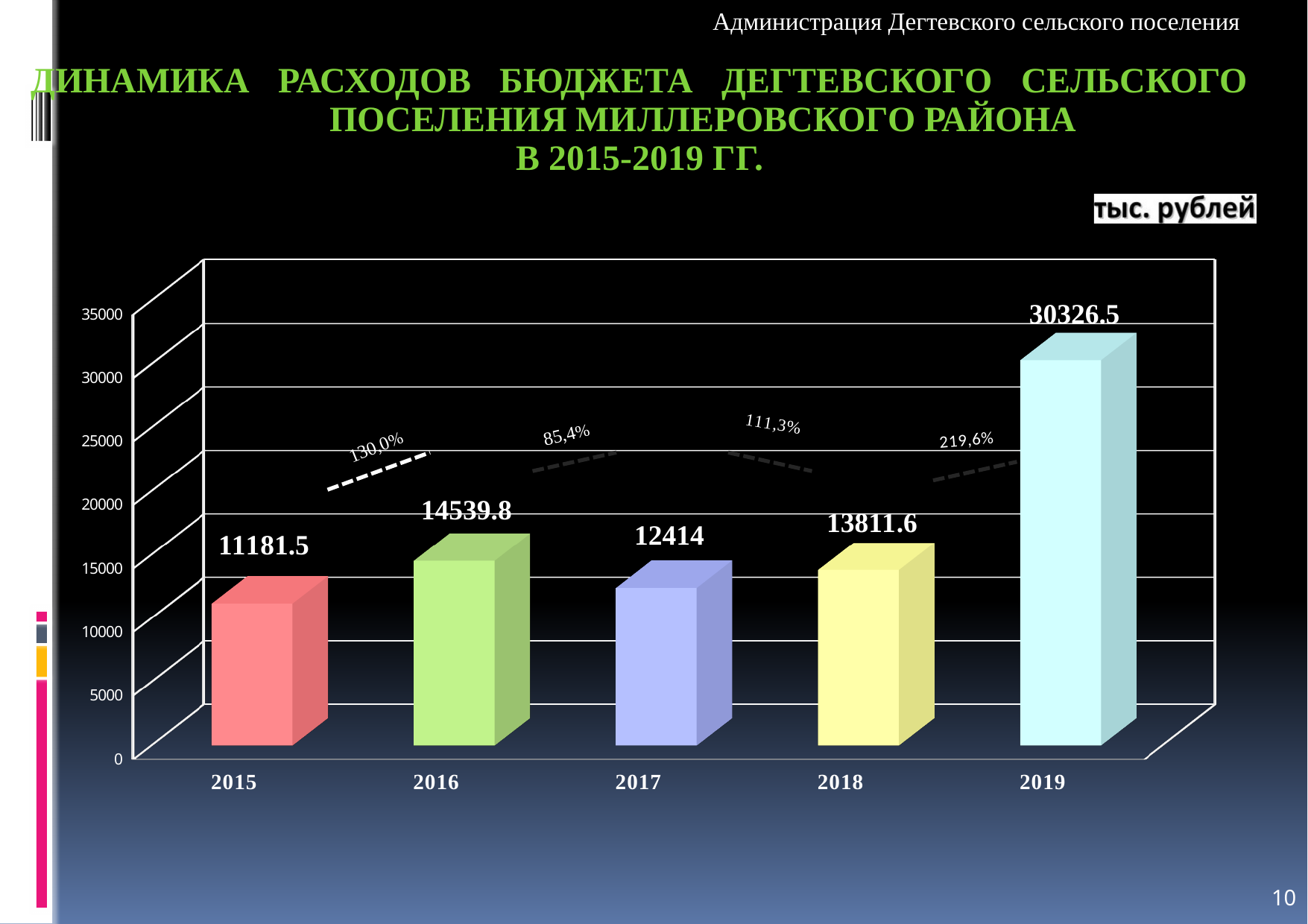
What kind of chart is shown on the slide? bar chart Which is larger, the value for 2016 or the value for 2018? 2016 What is the value for 2017? 12414 Which year has the lowest value? 2015 Does the value rise or fall from 2016 to 2017? fall What is the value for 2015? 11181.5 How many years are shown on the x axis? 5 Which year has the highest value? 2019 What unit is indicated in the label at the top right of the chart? тыс. рублей What is the value for 2019? 30326.5 What is the difference between the values for 2019 and 2018? 16514.9 What is the difference between the values for 2016 and 2015? 3358.3